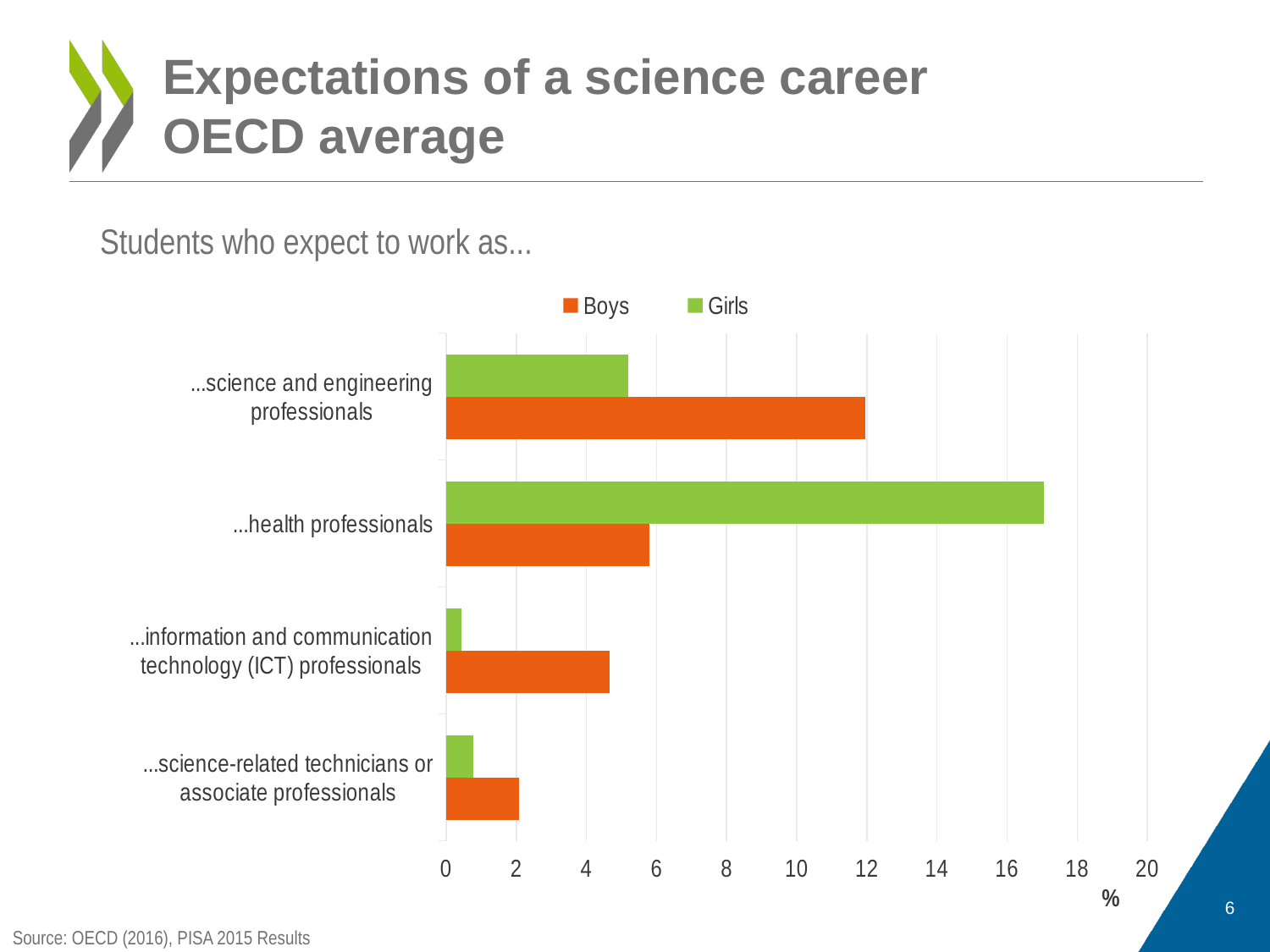
Which career category has the lowest value for Boys? ...science-related technicians or associate professionals Which career category has the highest value for Girls? ...health professionals Which career category has the lowest value for Girls? ...information and communication technology (ICT) professionals Which colour represents Girls in the chart? green Which career category has the highest value for Boys? ...science and engineering professionals How many career categories are plotted on the chart? 4 What kind of chart is shown on the slide? bar chart For health professionals, which is larger, the value for Boys or for Girls? Girls For ICT professionals, which is larger, the value for Boys or for Girls? Boys Is the value for Boys who expect to work as science-related technicians or associate professionals greater or less than 4? less Is the value for Girls who expect to work as health professionals greater or less than 16? greater How many series does the legend list? 2